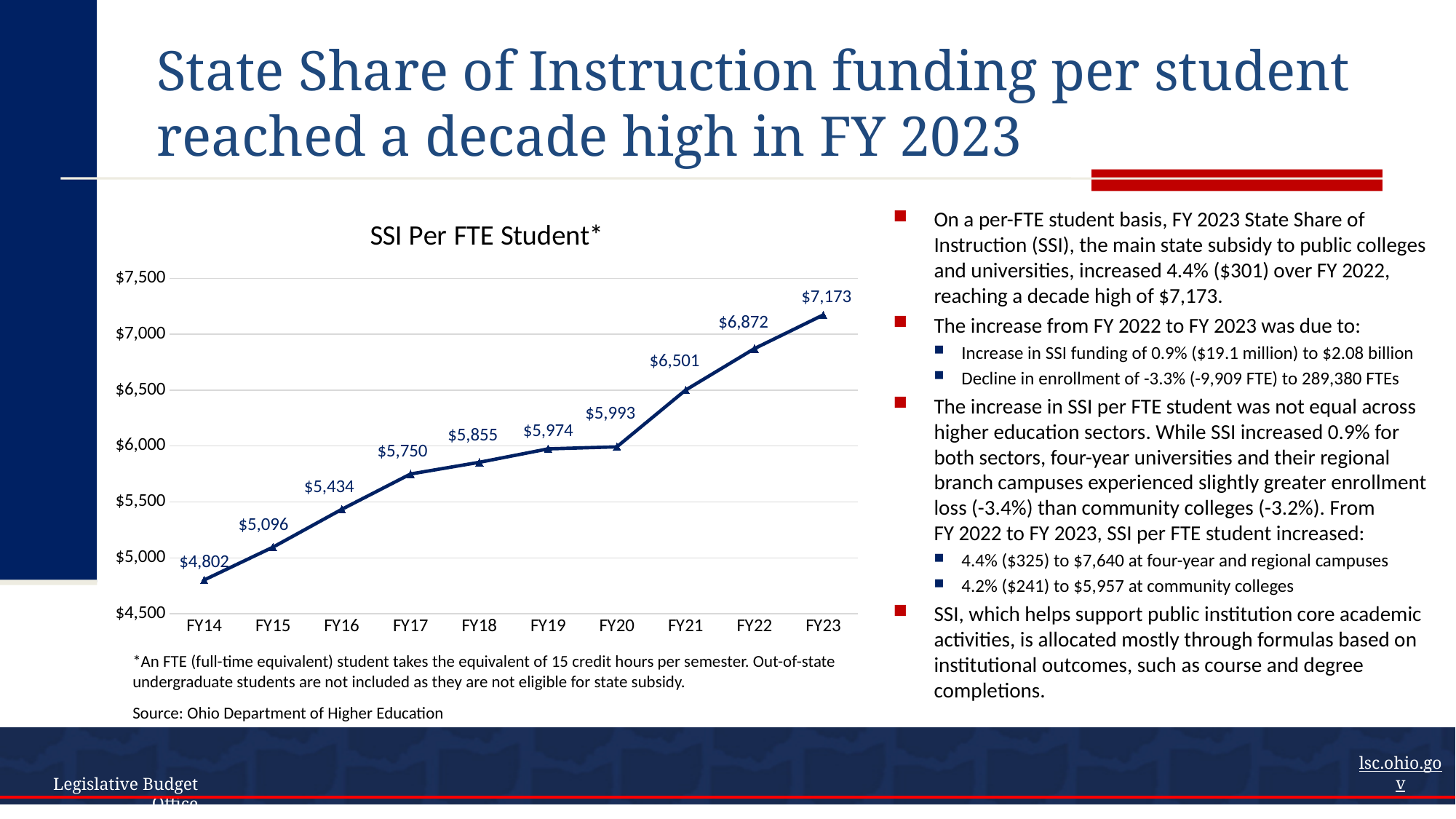
What is the difference in SSI per FTE student between FY23 and FY22? $301 What kind of chart is shown on the slide? line chart Which fiscal year has the highest SSI per FTE student? FY23 What is the difference in SSI per FTE student between FY21 and FY20? $508 Which is larger, the SSI per FTE student in FY17 or in FY16? FY17 Which fiscal year has the lowest SSI per FTE student? FY14 How many fiscal years are plotted on the chart? 10 Does SSI per FTE student rise or fall from FY14 to FY23? rise Is the SSI per FTE student value for FY21 greater or less than $6,500? greater What is the SSI per FTE student value for FY14? $4,802 What is the SSI per FTE student value for FY20? $5,993 What is the SSI per FTE student value for FY23? $7,173